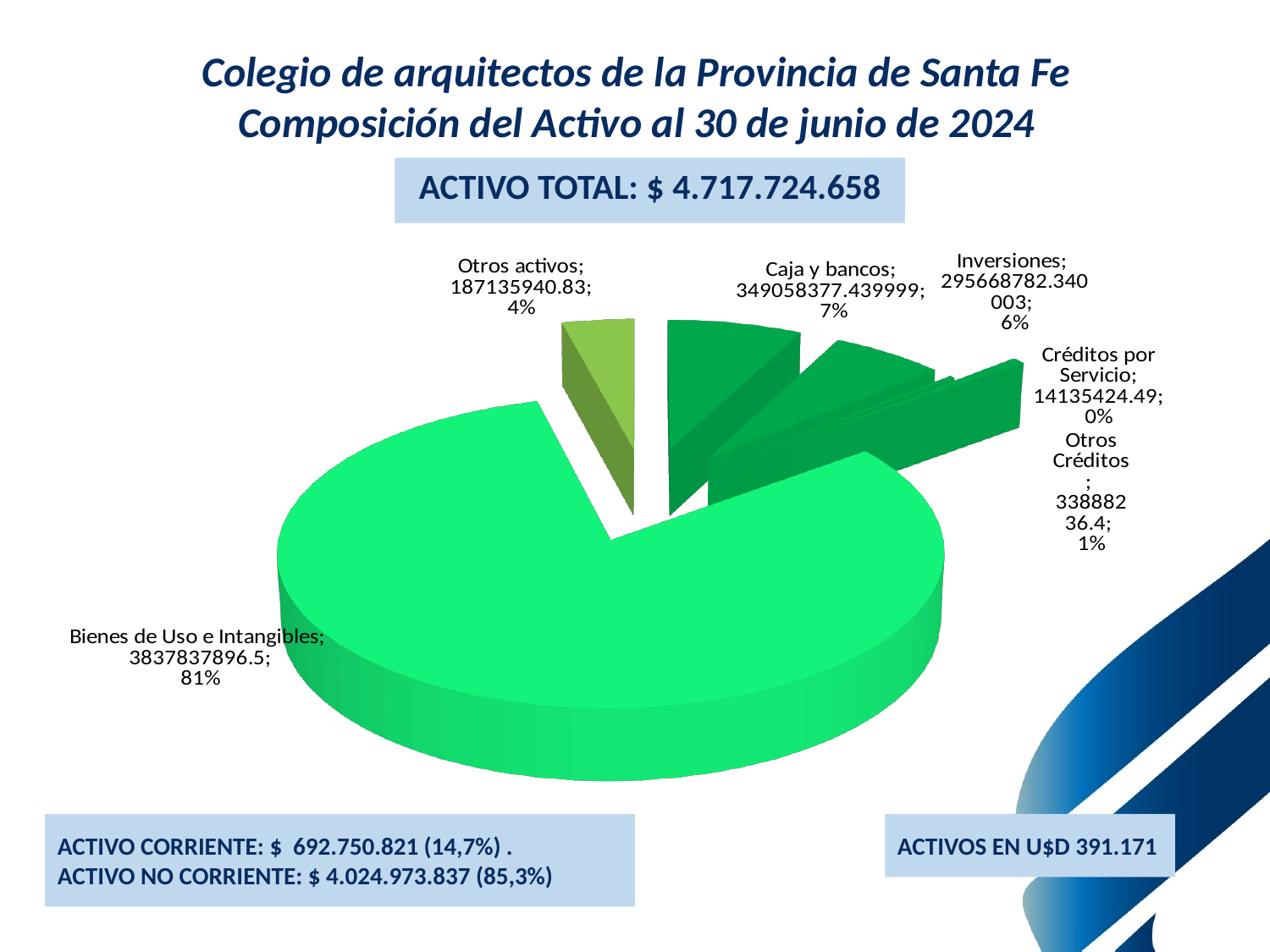
What percentage share does Otros Créditos have in the pie chart? 1% What is the ACTIVO TOTAL stated on the slide? $ 4.717.724.658 What is the value shown for Otros activos? 187135940.83 What is the value shown for Caja y bancos? 349058377.439999 What kind of chart is shown on the slide? pie chart How many slices does the pie chart have? 6 What percentage share does Bienes de Uso e Intangibles have in the pie chart? 81% Which is larger, the share for Caja y bancos or the share for Otros activos? Caja y bancos Which category has the largest slice in the pie chart? Bienes de Uso e Intangibles Which category has the smallest slice in the pie chart? Créditos por Servicio What is the value shown for Créditos por Servicio? 14135424.49 What percentage share does Inversiones have in the pie chart? 6%